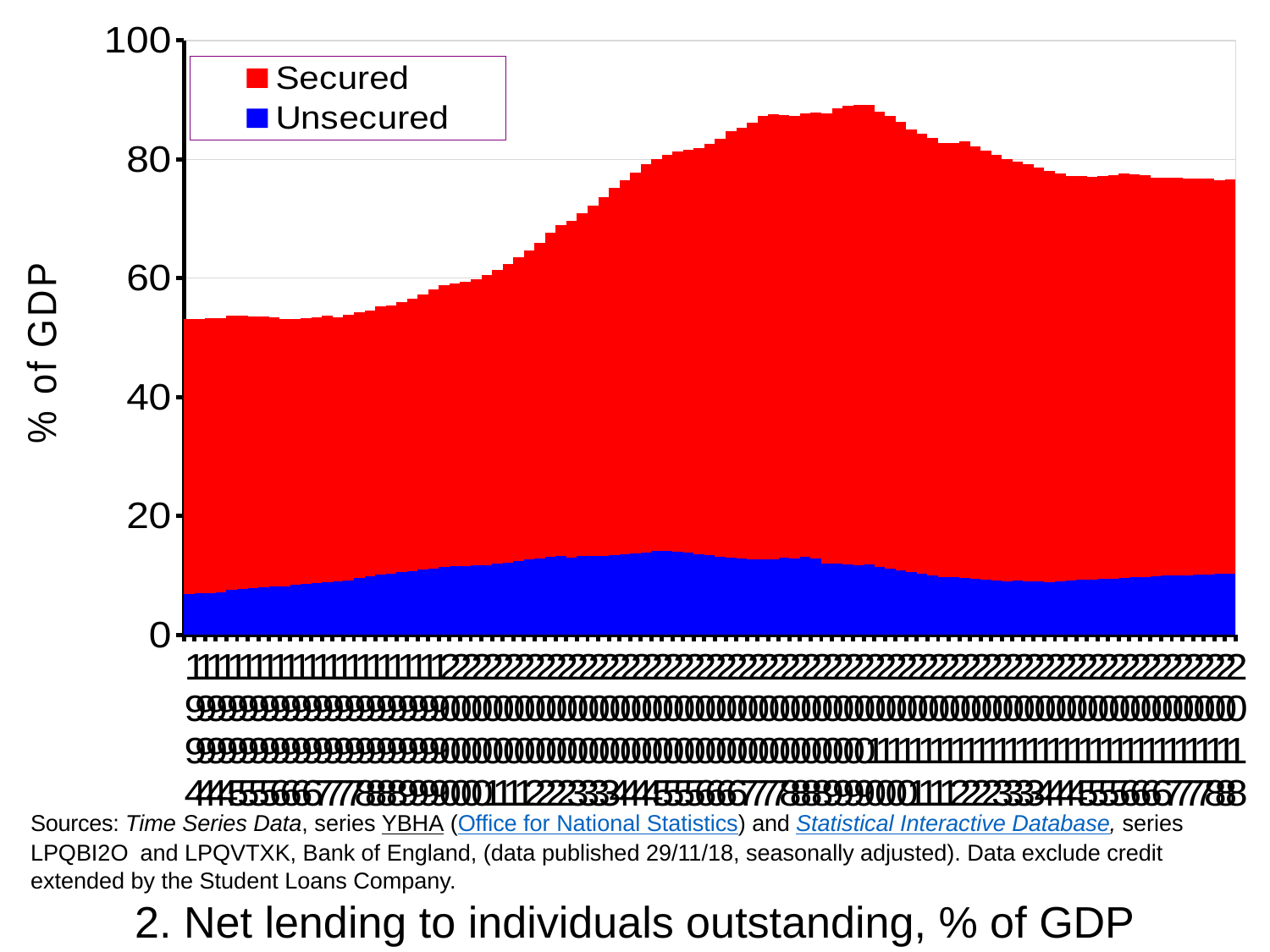
Is the highest total value reached by the stacked bars greater or less than 80? greater Is the total value of the first (leftmost) bar greater or less than 50? greater What kind of chart is shown on the slide? Stacked bar chart What are the two series named in the legend? Secured and Unsecured Is the Unsecured value in the first (leftmost) bar greater or less than 10? less Which series, Secured or Unsecured, accounts for the larger share of the stacked bars? Secured What is the label on the vertical axis? % of GDP How many series does the legend list? 2 Does the total of the stacked bars rise or fall from the leftmost bar to the peak in the middle of the chart? rise After reaching its peak, does the total of the stacked bars rise or fall towards the right end of the chart? fall